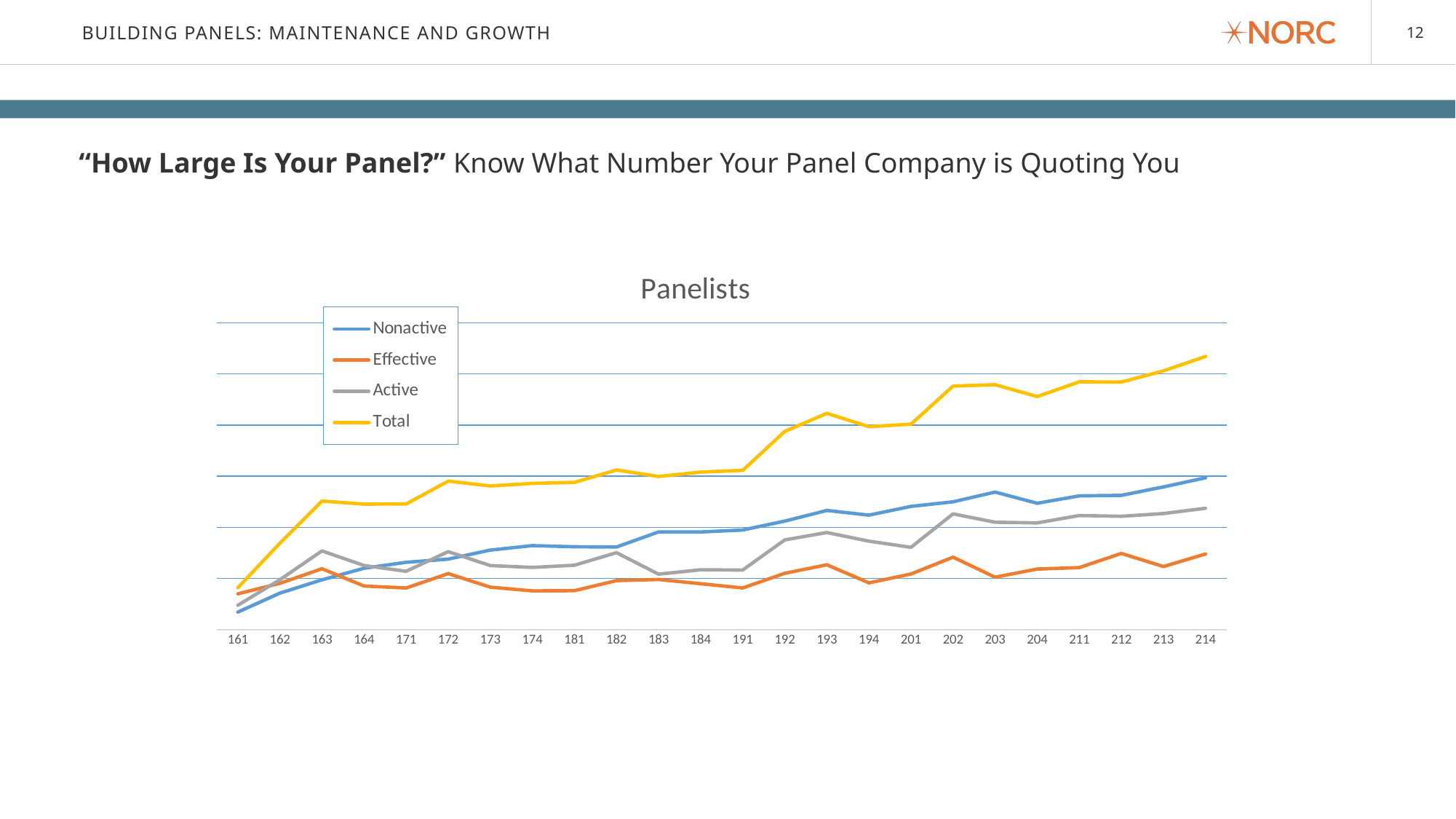
Which series has the highest value at 214? Total What is the title of the chart? Panelists How many series does the legend of the Panelists chart list? 4 Does the Nonactive series generally rise or fall from 161 to 214? rise Which series is drawn in yellow in the Panelists chart? Total At 161, which is larger: Effective or Nonactive? Effective How many points are plotted along the x axis of the Panelists chart? 24 At 214, which is larger: Nonactive or Active? Nonactive Which series has the lowest value at 214? Effective Which series has the lowest value at 161? Nonactive What type of chart is shown on the slide? line chart Does the Total series generally rise or fall from 161 to 214? rise